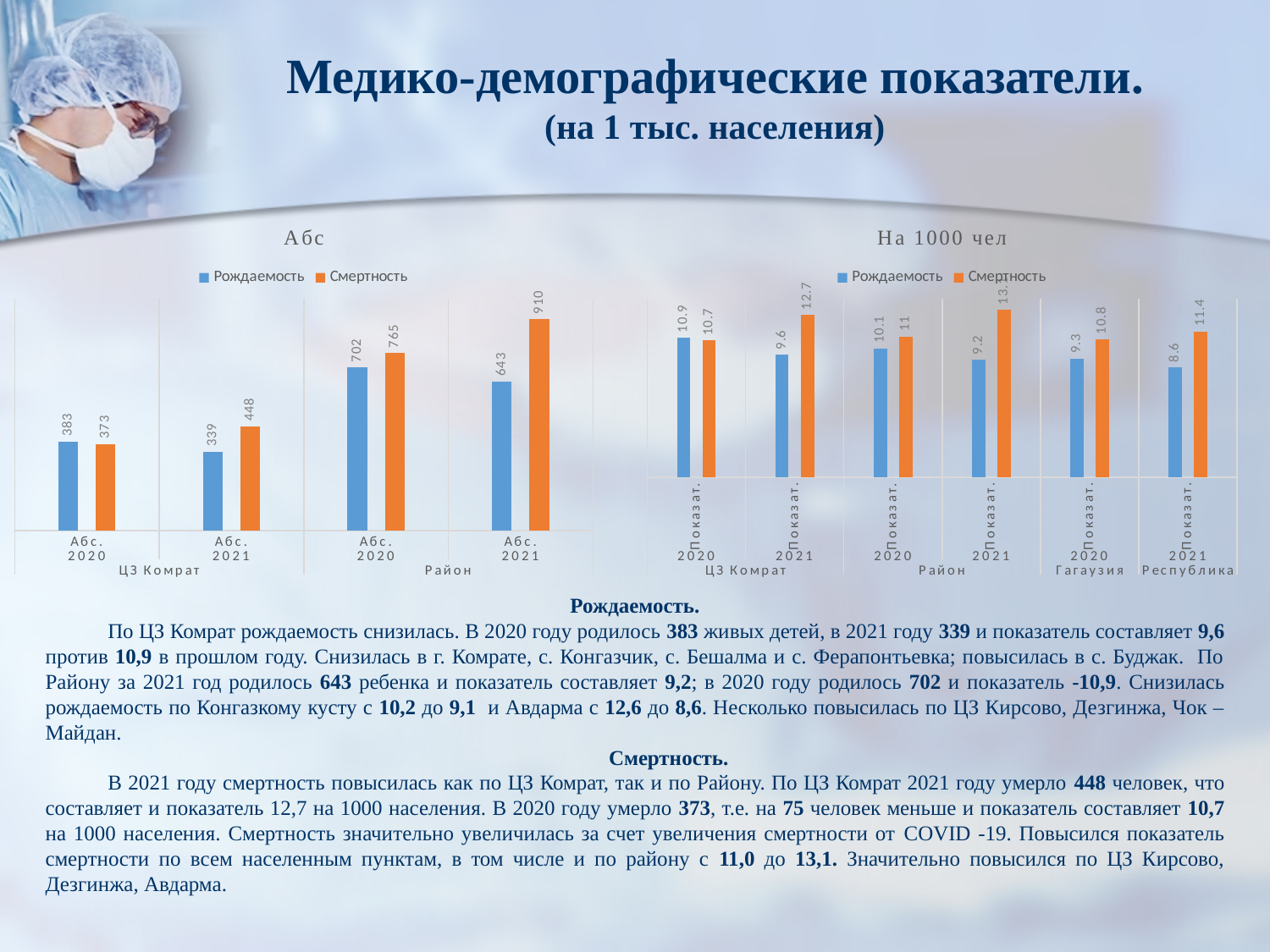
In the chart titled "Абс", which category has the lowest Рождаемость value? Абс. 2021 (ЦЗ Комрат) In the chart titled "На 1000 чел", what is the difference between Смертность and Рождаемость for Показат. 2020 under Гагаузия? 1.5 In the chart titled "На 1000 чел", which is larger for Показат. 2020 under ЦЗ Комрат: Рождаемость or Смертность? Рождаемость In the chart titled "На 1000 чел", how many category groups (pairs of bars) are plotted? 6 In the chart titled "Абс", what is the value of Смертность for Абс. 2021 under Район? 910 In the chart titled "Абс", which category has the highest Смертность value? Абс. 2021 (Район) In the chart titled "На 1000 чел", what is the Смертность value for Показат. 2021 under Республика? 11.4 In the chart titled "Абс", what is the difference between Смертность and Рождаемость for Абс. 2021 under ЦЗ Комрат? 109 In the chart titled "Абс", how many series does the legend list? 2 In the chart titled "На 1000 чел", what is the Рождаемость value for Показат. 2021 under ЦЗ Комрат? 9.6 In the chart titled "Абс", what is the value of Рождаемость for Абс. 2020 under ЦЗ Комрат? 383 What type of chart is the chart titled "На 1000 чел"? Bar chart